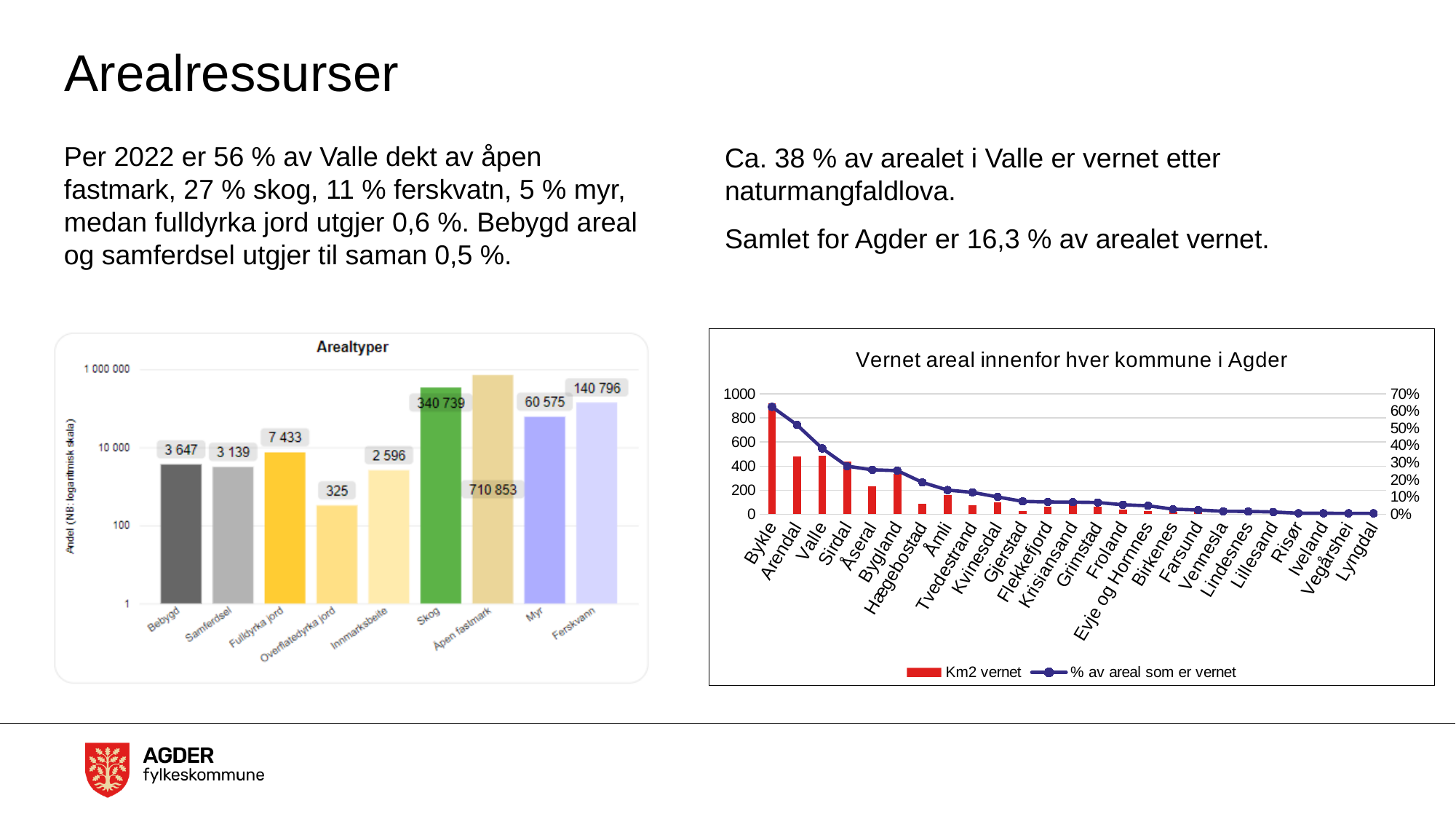
In the chart 'Vernet areal innenfor hver kommune i Agder', how many series does the legend list? 2 In the chart 'Vernet areal innenfor hver kommune i Agder', is the Km2 vernet value for Bykle greater or less than 800? greater In the chart 'Vernet areal innenfor hver kommune i Agder', does the '% av areal som er vernet' line rise or fall from left to right? Fall In the Arealtyper chart, which category has the lowest value? Overflatedyrka jord In the Arealtyper chart, which category has the highest value? Åpen fastmark In the Arealtyper chart, what is the difference between Ferskvann and Myr? 80 221 In the Arealtyper chart, what is the value for Overflatedyrka jord? 325 What kind of chart is the Arealtyper chart? Bar chart In the chart 'Vernet areal innenfor hver kommune i Agder', which municipality has the highest Km2 vernet? Bykle How many categories are shown in the Arealtyper chart? 9 In the Arealtyper chart, which is larger, Bebygd or Samferdsel? Bebygd In the Arealtyper chart, what is the value for Skog? 340 739